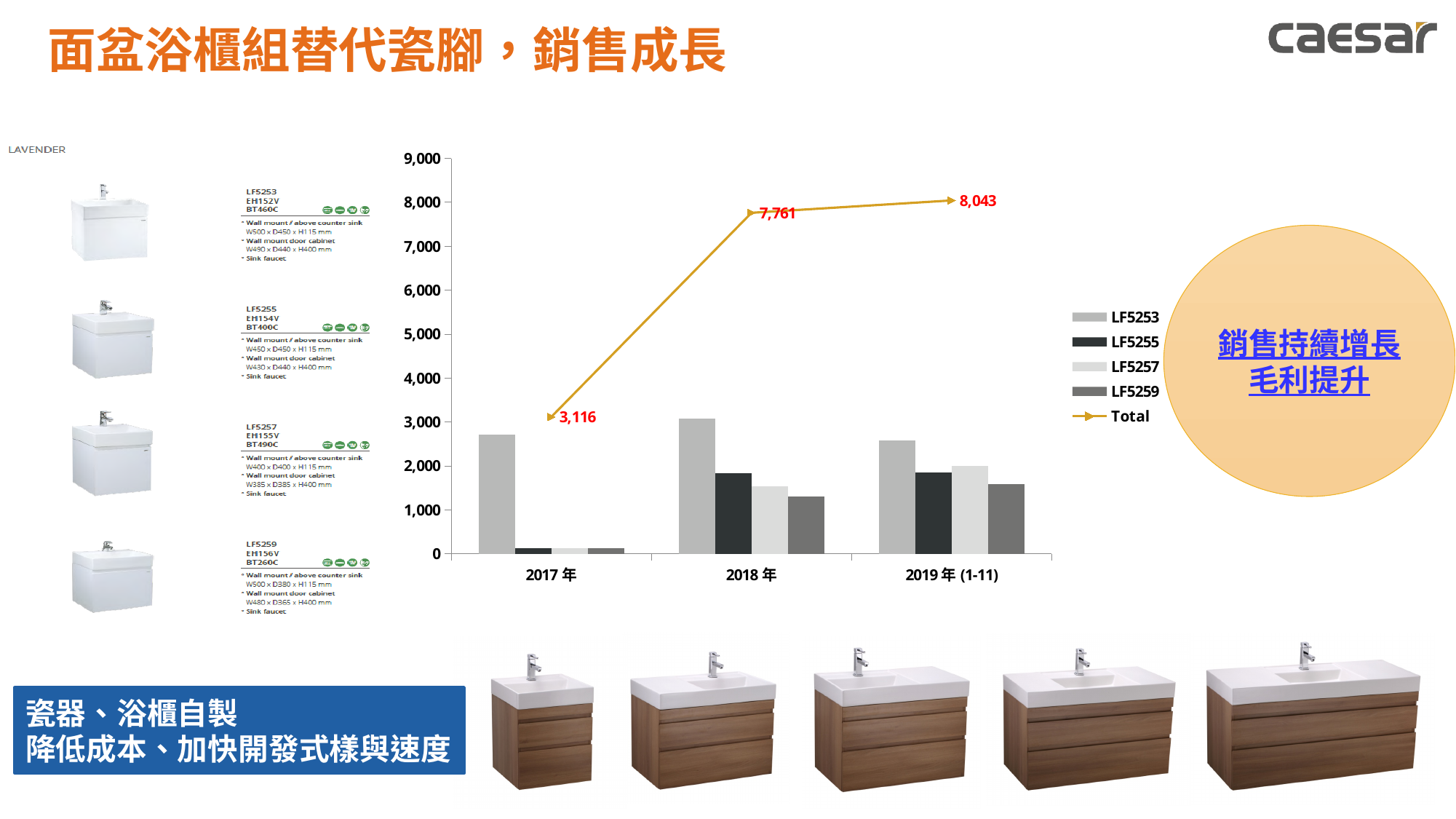
Is the value for LF5253 in 2017 年 greater or less than 2,000? greater What is the difference between the Total for 2018 年 and 2017 年? 4,645 Is the value for LF5255 in 2017 年 greater or less than 1,000? less How many series does the legend list? 5 In 2018 年, which series has the taller bar, LF5253 or LF5255? LF5253 Does the Total line rise or fall from 2017 年 to 2019 年 (1-11)? rise In which year is the Total lowest? 2017 年 In which year is the Total highest? 2019 年 (1-11) What is the Total value for 2018 年? 7,761 What is the difference between the Total for 2019 年 (1-11) and 2018 年? 282 What is the Total value for 2019 年 (1-11)? 8,043 What is the Total value for 2017 年? 3,116